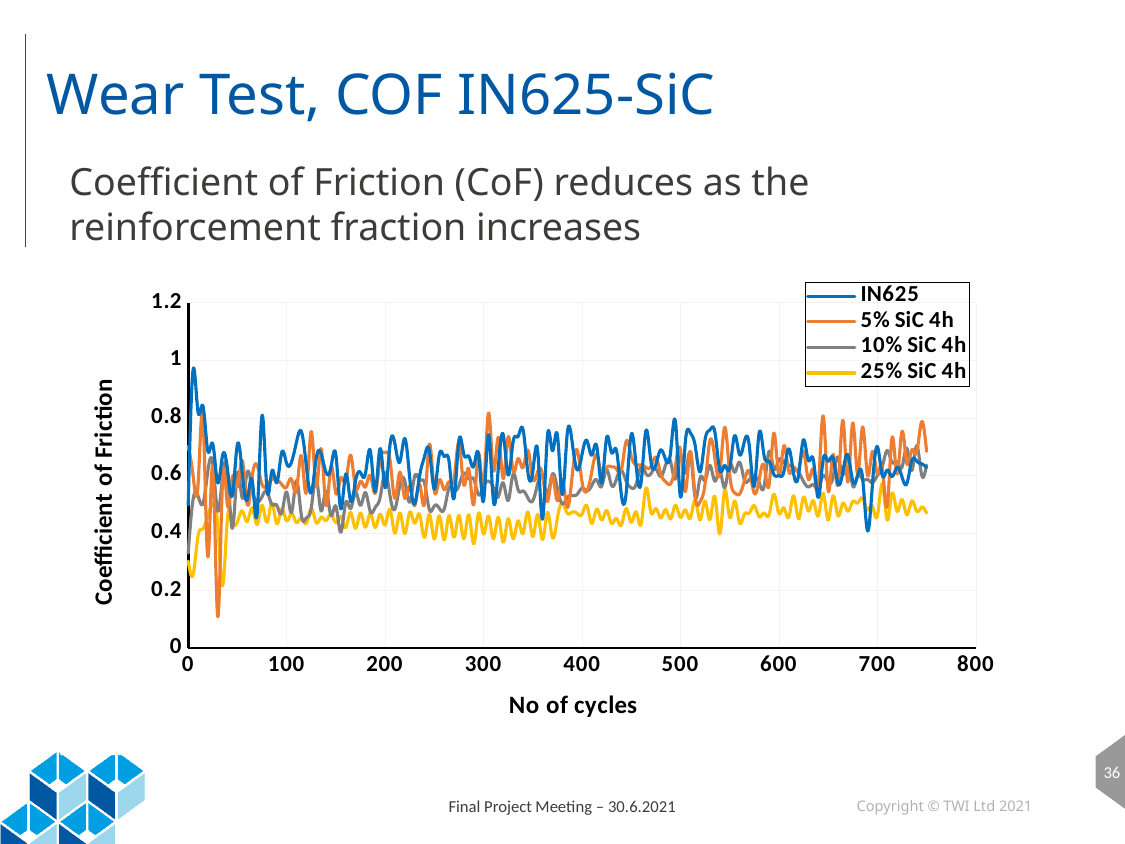
Is the coefficient of friction for 25% SiC 4h at 500 cycles greater or less than 0.6? less How many series does the legend list? 4 What is the label of the y axis? Coefficient of Friction What is the maximum value shown on the y axis? 1.2 Is the coefficient of friction for 10% SiC 4h at 600 cycles greater or less than 0.8? less Is the coefficient of friction for 25% SiC 4h at 200 cycles greater or less than 0.2? greater What kind of chart is shown on the slide? line chart Which series has the lowest coefficient of friction across most of the test? 25% SiC 4h Which series has a higher coefficient of friction at 400 cycles, IN625 or 25% SiC 4h? IN625 Which series is plotted in yellow? 25% SiC 4h